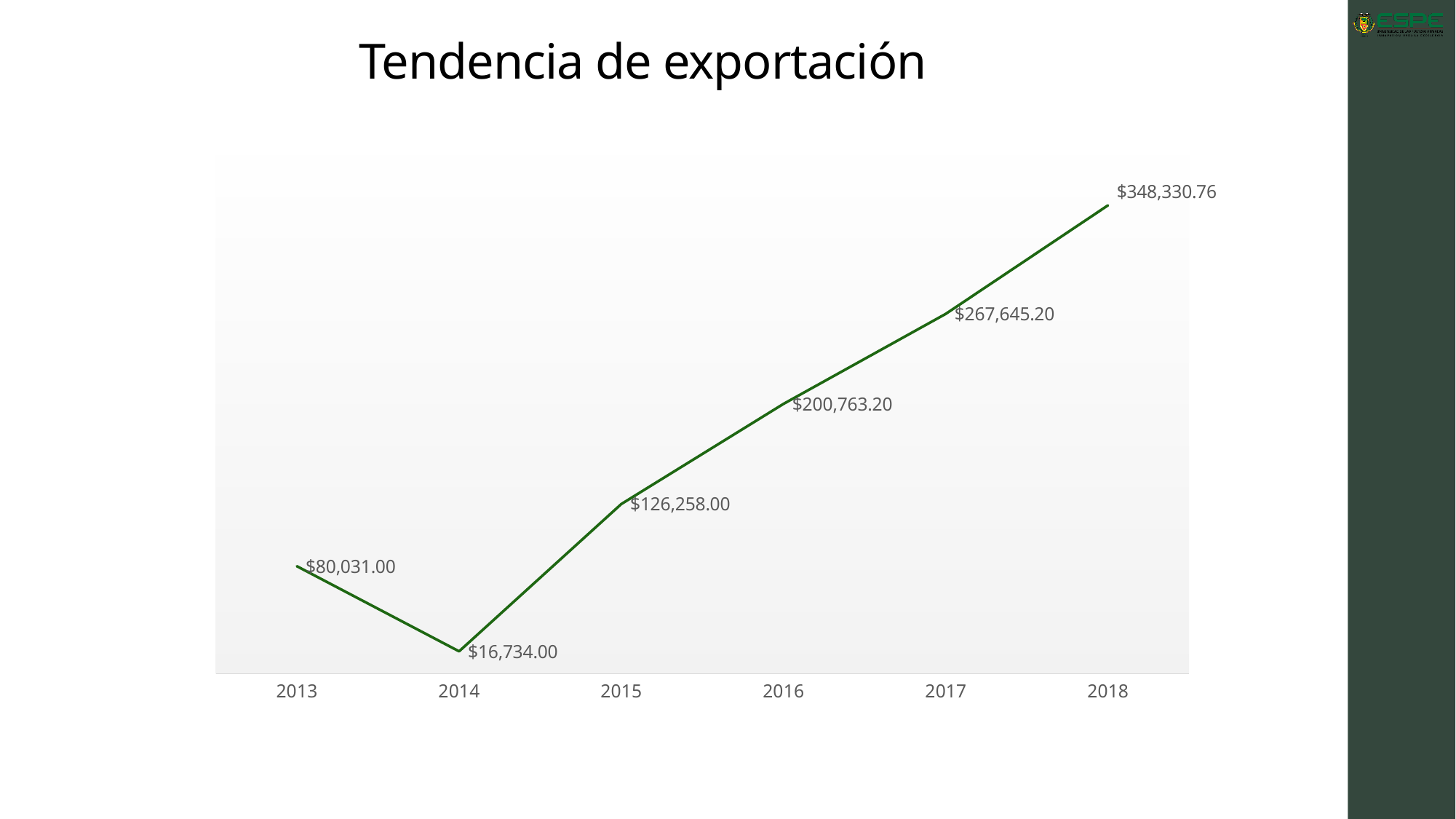
Which year has a larger export value, 2013 or 2015? 2015 What is the export value for 2016? $200,763.20 Which year has the highest export value? 2018 What is the title of the slide? Tendencia de exportación What is the export value for 2018? $348,330.76 What is the difference between the export values for 2013 and 2014? $63,297.00 What kind of chart is shown on the slide? Line chart How many years are plotted on the chart? 6 Do the export values rise or fall from 2014 to 2018? Rise What is the difference between the export values for 2018 and 2017? $80,685.56 What is the export value for 2014? $16,734.00 Which year has the lowest export value? 2014